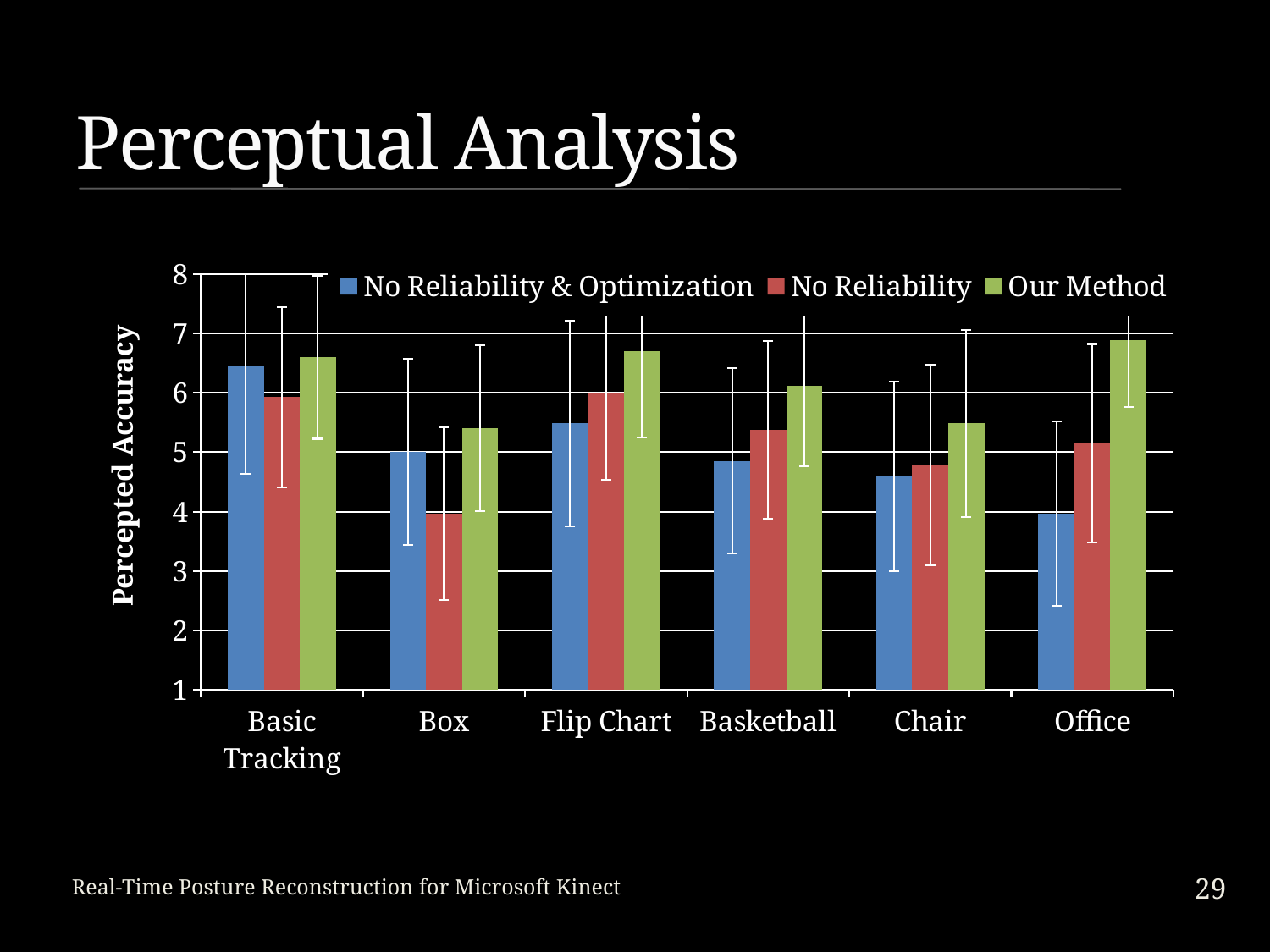
How many categories are shown on the x axis? 6 Which colour represents the "Our Method" series in the legend? green Is the value for Our Method in the Office category greater or less than 6? greater Is the value for No Reliability & Optimization in the Basketball category greater or less than 5? less Is the value for Our Method in the Box category greater or less than 5? greater How many series does the legend list? 3 What is the label of the y axis? Percepted Accuracy In the Office category, which is larger: No Reliability & Optimization or Our Method? Our Method In the Box category, which is larger: No Reliability or Our Method? Our Method What kind of chart is shown on the slide? bar chart In which category does the Our Method series reach its highest value? Office